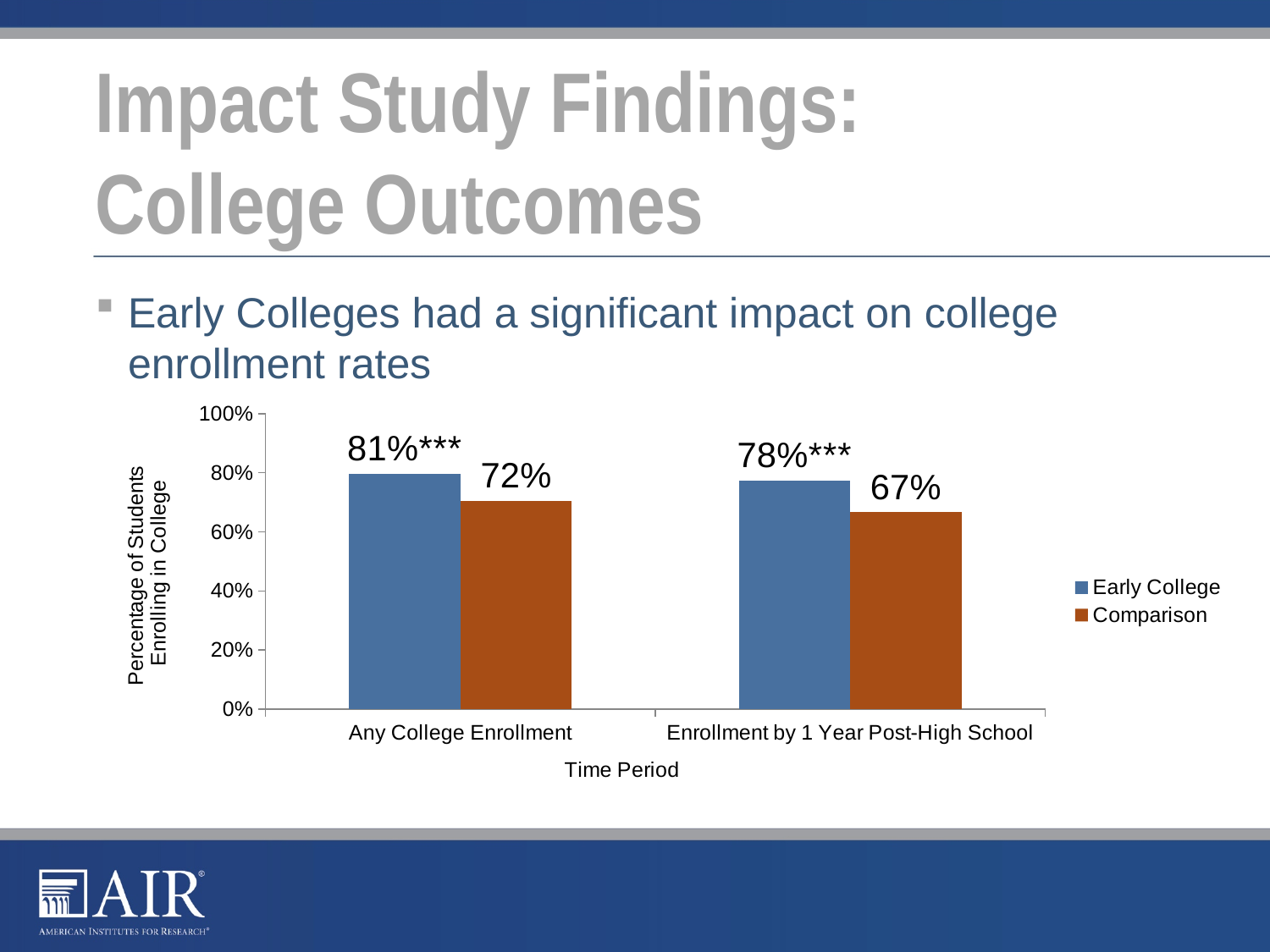
What is the difference between the Early College and Comparison values for Enrollment by 1 Year Post-High School? 11% What is the Comparison value for Any College Enrollment? 72% How many categories are shown on the x axis? 2 What is the difference between the Early College and Comparison values for Any College Enrollment? 9% What is the Early College value for Enrollment by 1 Year Post-High School? 78% What is the Early College value for Any College Enrollment? 81% Which is larger: the Early College value for Any College Enrollment or the Early College value for Enrollment by 1 Year Post-High School? Any College Enrollment How many series does the legend list? 2 What kind of chart is shown on the slide? bar chart Which series has the lowest value for Enrollment by 1 Year Post-High School? Comparison Is the Comparison value for Enrollment by 1 Year Post-High School greater or less than 80%? less What is the Comparison value for Enrollment by 1 Year Post-High School? 67%